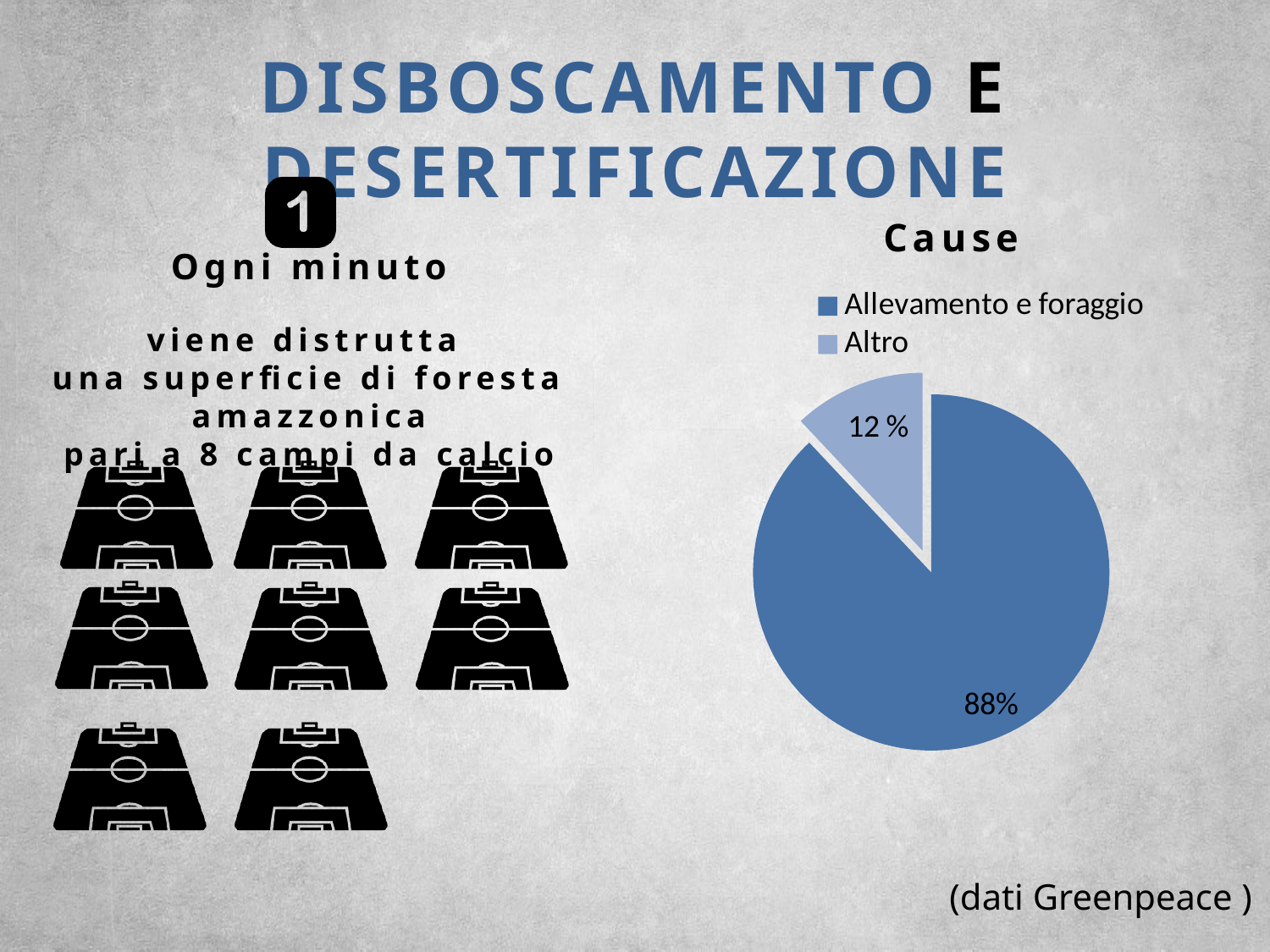
What share of the pie does "Allevamento e foraggio" represent? 88% What is the difference in percentage points between "Allevamento e foraggio" and "Altro"? 76 What is the title of the chart on the slide? Cause How many entries does the legend of the pie chart list? 2 Which slice of the pie chart is the smallest? Altro Which is larger in the pie chart, "Altro" or "Allevamento e foraggio"? Allevamento e foraggio Which legend entry is shown in the lighter blue colour? Altro Which slice of the pie chart is the largest? Allevamento e foraggio What share of the pie does "Altro" represent? 12 % What type of chart is shown under the title "Cause"? pie chart How many slices does the pie chart have? 2